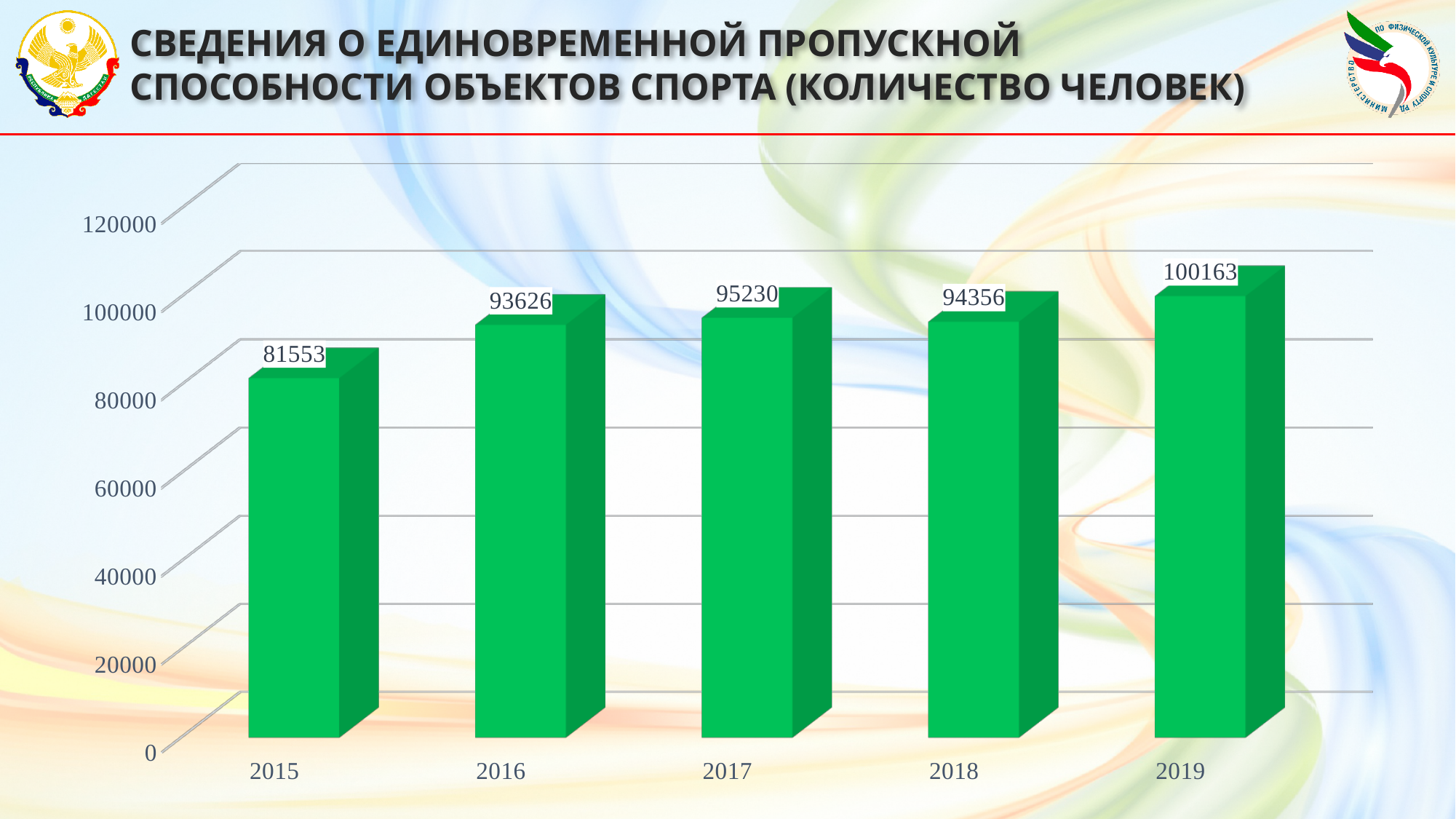
What is the difference between the values for 2019 and 2015? 18610 Is the value for 2015 greater or less than 100000? less Which year has the highest value? 2019 What kind of chart is shown on the slide? bar chart What is the value for 2019? 100163 What is the value for 2015? 81553 What is the difference between the values for 2017 and 2018? 874 Which year has the lowest value? 2015 Which is larger, the value for 2016 or the value for 2018? 2018 What is the value for 2017? 95230 How many years are shown on the chart? 5 What colour are the bars on the chart? green